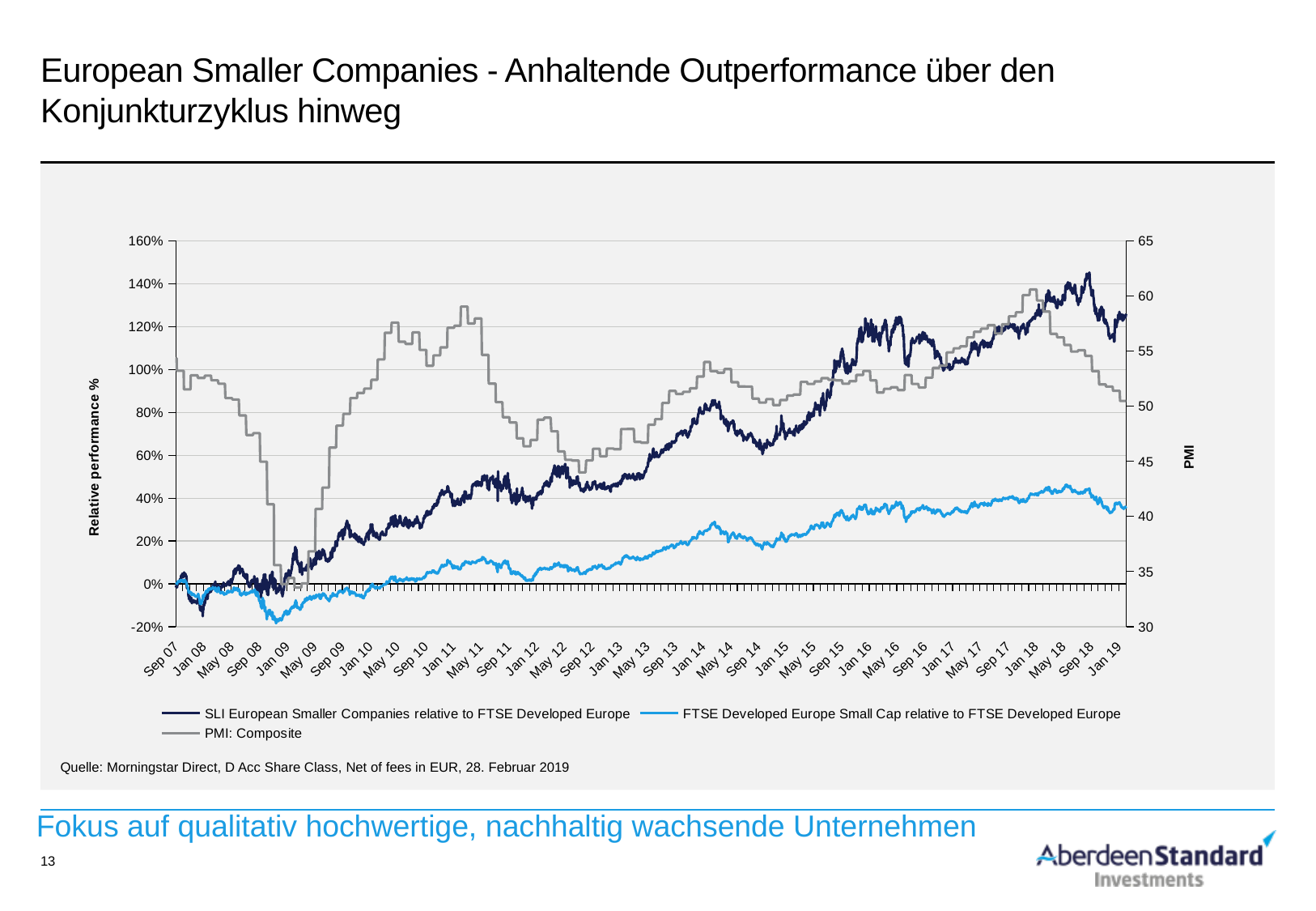
What is the title of the left vertical axis? Relative performance % At Jan 19, which is larger: SLI European Smaller Companies relative to FTSE Developed Europe or FTSE Developed Europe Small Cap relative to FTSE Developed Europe? SLI European Smaller Companies relative to FTSE Developed Europe Is the value of FTSE Developed Europe Small Cap relative to FTSE Developed Europe at Jan 09 greater or less than 0%? less Is the PMI: Composite value at Jan 09 greater or less than 40? less Is the value of SLI European Smaller Companies relative to FTSE Developed Europe at Jan 19 greater or less than 100%? greater Does the SLI European Smaller Companies relative to FTSE Developed Europe line rise or fall overall from Sep 07 to Jan 19? Rise What kind of chart is shown on the slide? Line chart What is the title of the right vertical axis? PMI Which series reaches the highest relative performance on the left axis? SLI European Smaller Companies relative to FTSE Developed Europe How many series does the legend list? 3